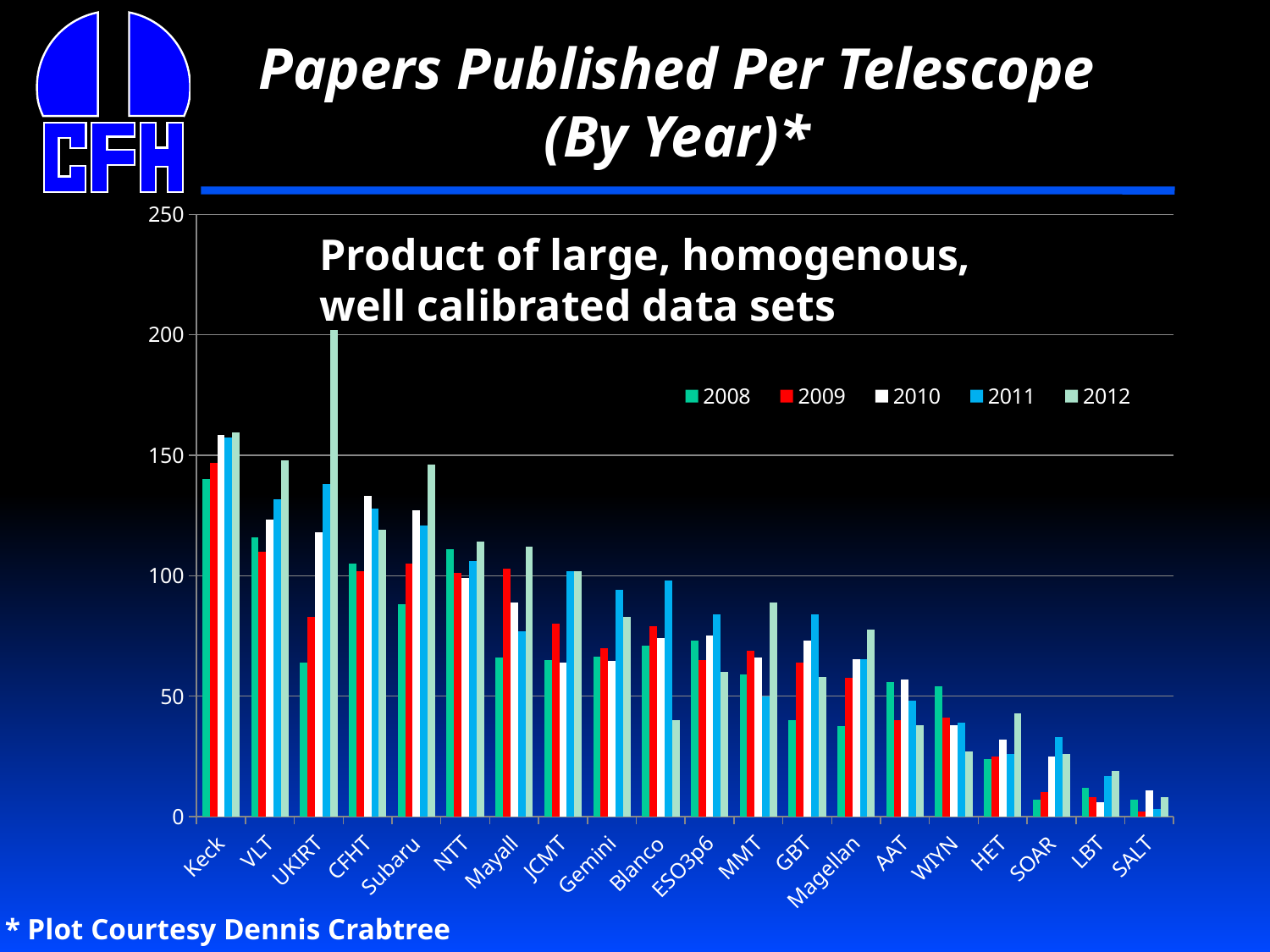
Which telescope has the highest value for 2012? UKIRT How many series does the chart's legend list? 5 Which telescope has the highest value for 2008? Keck Is the value for CFHT in 2012 greater or less than 150? less Do the 2008 values generally rise or fall moving from Keck on the left to SALT on the right? fall Which telescope has the lowest value for 2011? SALT Is the value for Keck in 2009 greater or less than 100? greater What kind of chart is shown on the slide? bar chart For Blanco, which year has the larger value, 2011 or 2012? 2011 How many telescopes are listed along the x axis of the chart? 20 Which colour represents the 2009 series in the legend? red Is the value for Blanco in 2012 greater or less than 50? less